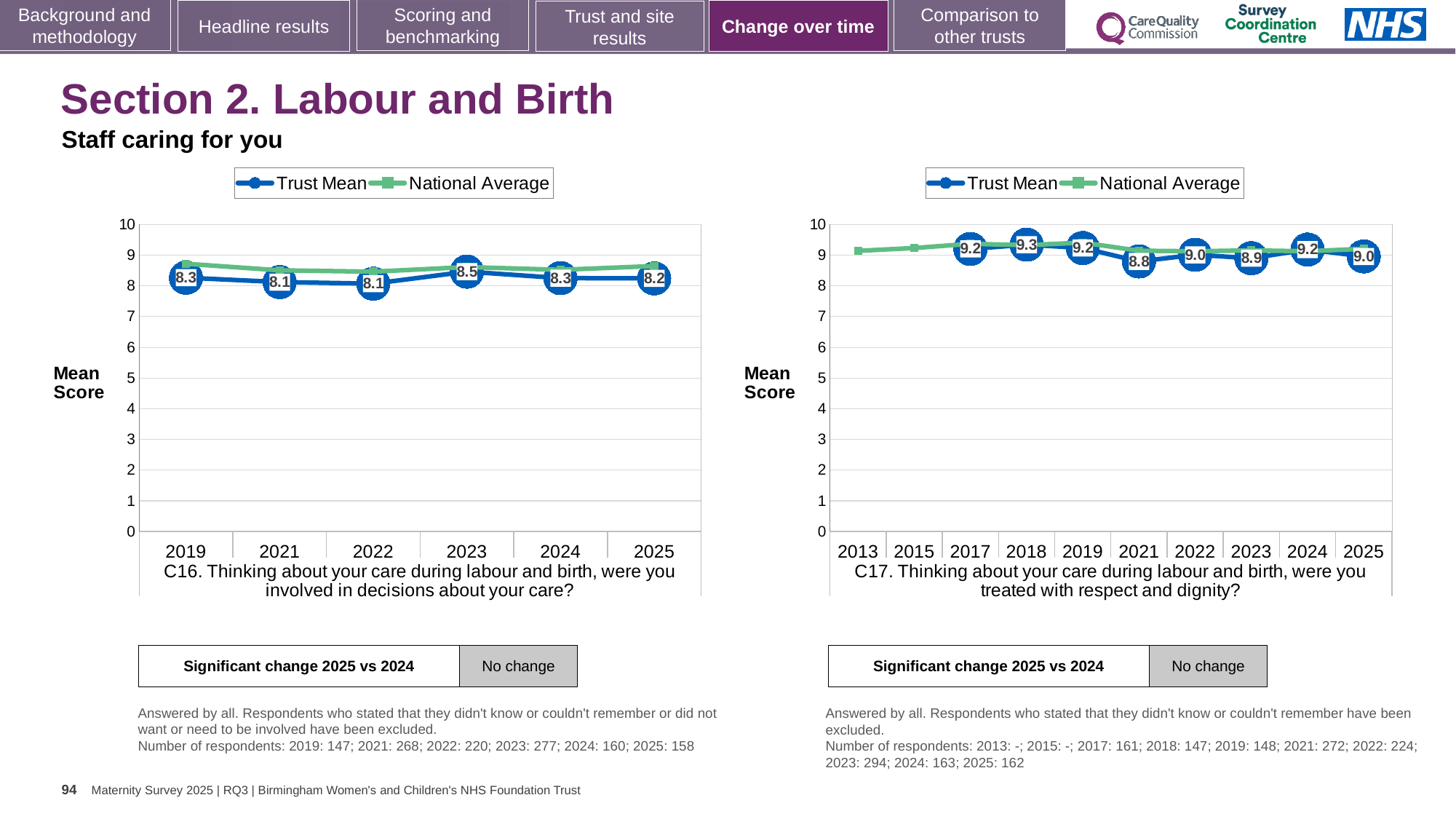
In the C17 chart, how many series does the legend list? 2 In the C16 chart, how many years are shown on the x axis? 6 In the C16 chart, what is the difference between the Trust Mean in 2023 and in 2022? 0.4 What kind of chart is the C17 chart? line chart In the C17 chart, what is the Trust Mean for 2018? 9.3 In the C16 chart, is the National Average for 2019 greater or less than 8? greater In the C17 chart, what is the Trust Mean for 2021? 8.8 In the C16 chart, what is the Trust Mean for 2023? 8.5 In the C17 chart, is the Trust Mean for 2024 larger or smaller than the Trust Mean for 2025? larger In the C16 chart, what is the Trust Mean for 2025? 8.2 In the C17 chart, which year has the lowest labelled Trust Mean? 2021 In the C16 chart, which year has the highest Trust Mean? 2023